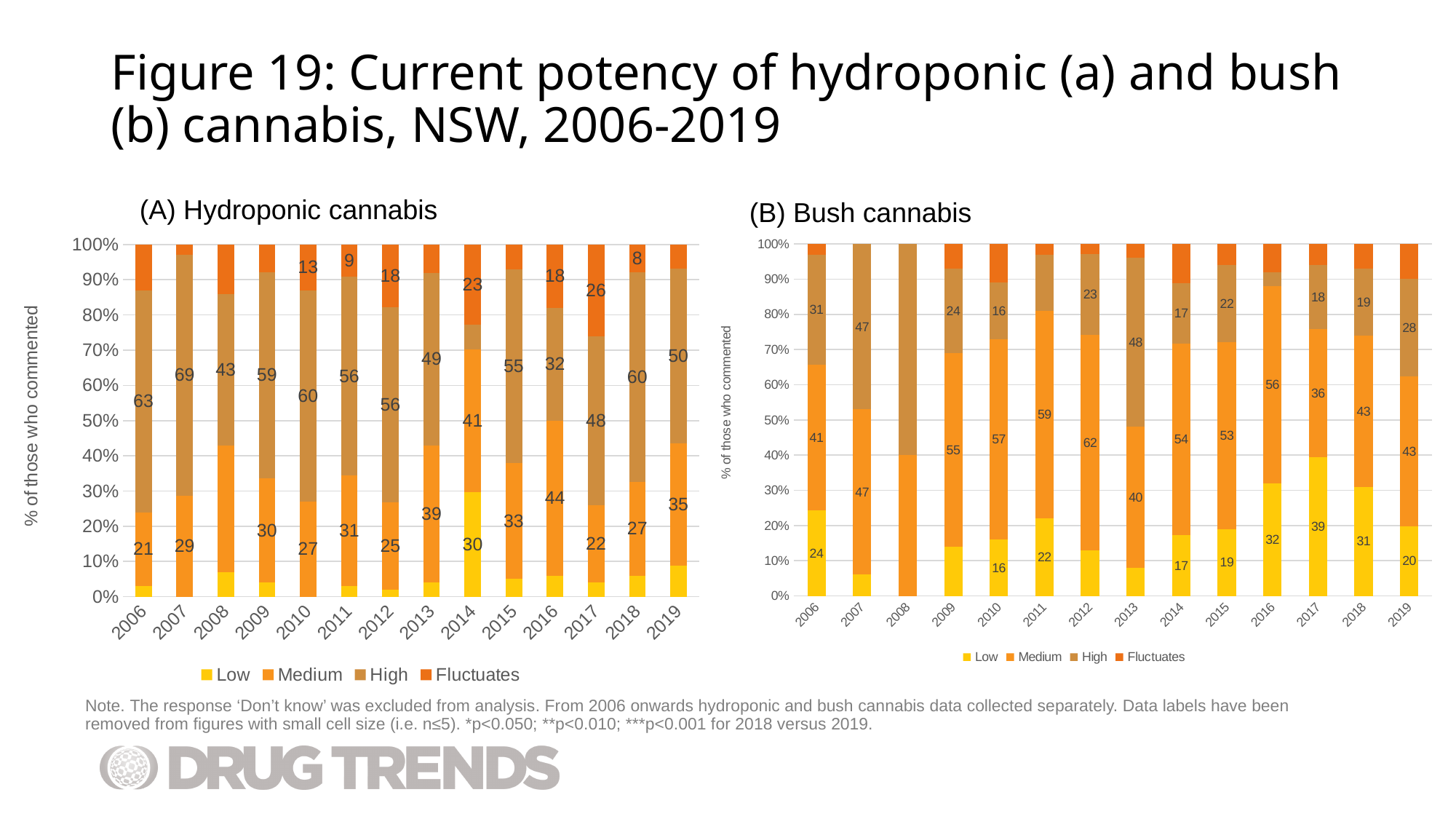
In the (A) Hydroponic cannabis chart, which is larger in 2016: Medium or High? Medium What kind of chart is the (A) Hydroponic cannabis chart? Stacked bar chart In the (A) Hydroponic cannabis chart, which year has the highest labelled High value? 2007 In the (B) Bush cannabis chart, what percentage reported Medium potency in 2012? 62 In the (A) Hydroponic cannabis chart, what is the difference between the Medium and Low values in 2014? 11 In the (A) Hydroponic cannabis chart, what is the Fluctuates value for 2017? 26 How many years are shown on the x axis of the (A) Hydroponic cannabis chart? 14 In the (A) Hydroponic cannabis chart, what percentage reported High potency in 2007? 69 In the (B) Bush cannabis chart, is the Medium segment for 2008 greater or less than 50%? less In the (B) Bush cannabis chart, which year has the highest Low value? 2017 How many series does the legend of the (B) Bush cannabis chart list? 4 In the (B) Bush cannabis chart, does the Low value rise or fall from 2014 to 2017? Rise